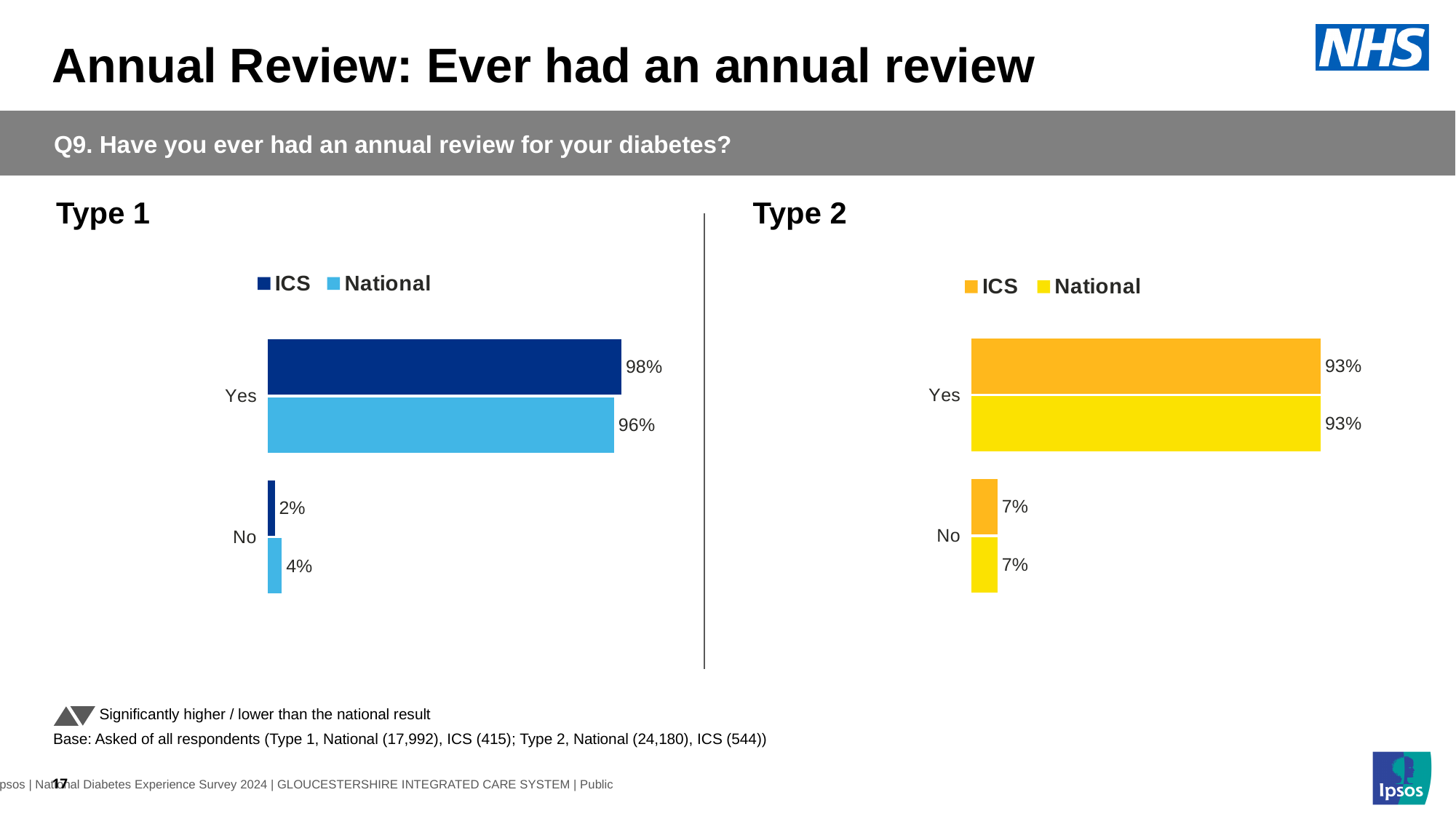
What kind of chart is the Type 2 chart? Bar chart In the Type 1 chart, which category has the lowest ICS value? No In the Type 1 chart, which is larger for No: ICS or National? National In the Type 2 chart, what is the ICS value for Yes? 93% In the Type 2 chart, what are the two legend entries? ICS and National In the Type 2 chart, how many categories are shown? 2 In the Type 1 chart, what is the difference between the ICS and National values for Yes? 2 percentage points In the Type 1 chart, what is the National value for No? 4% In the Type 2 chart, what is the National value for No? 7% In the Type 2 chart, what is the difference between the ICS and National values for Yes? 0 percentage points In the Type 1 chart, how many series does the legend list? 2 In the Type 1 chart, what is the ICS value for Yes? 98%